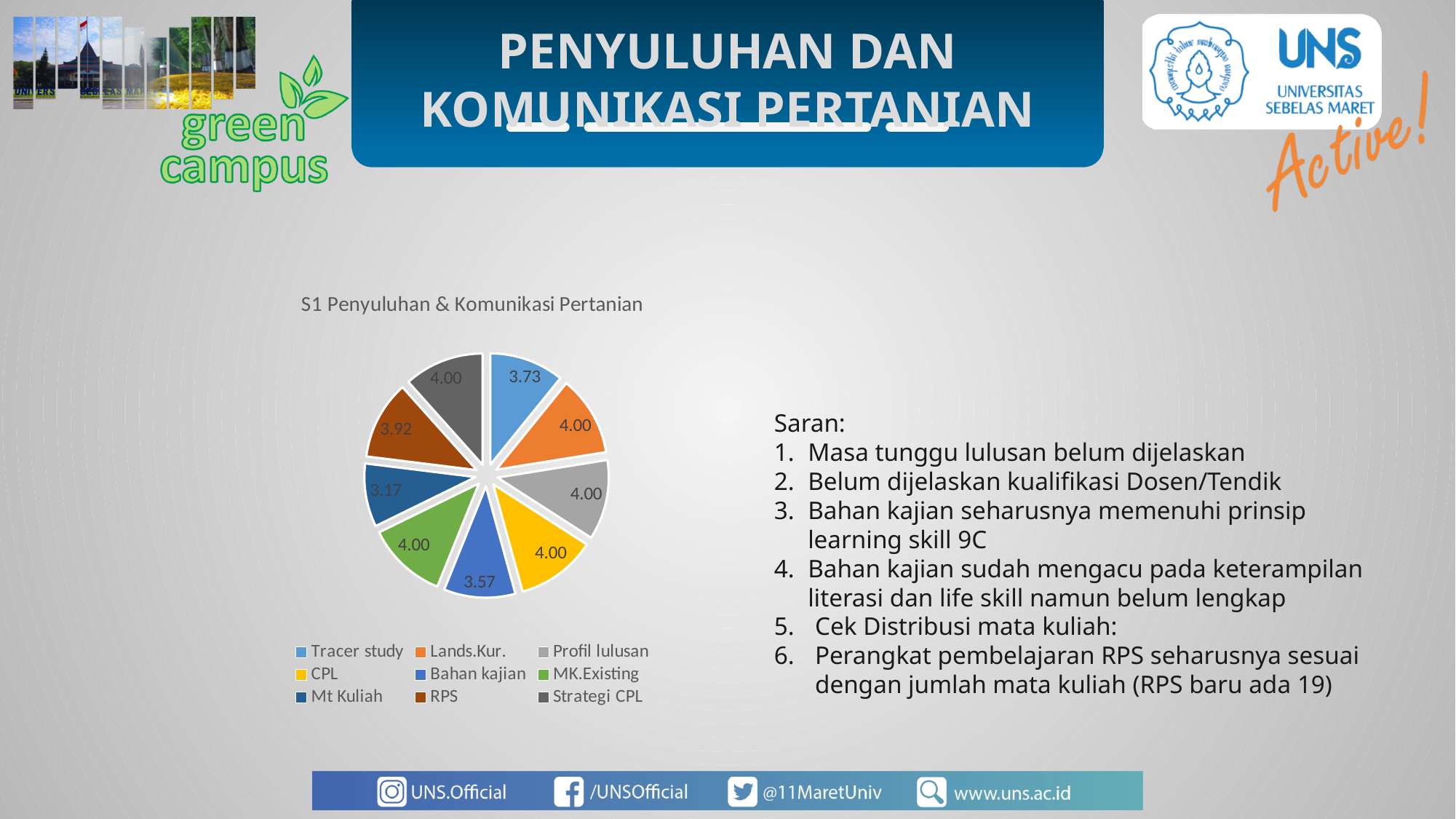
What is the difference between the values for Tracer study and Mt Kuliah? 0.56 What is the value for Tracer study? 3.73 Which is larger, the value for Tracer study or the value for Bahan kajian? Tracer study What kind of chart is shown on the slide? pie chart What is the value for Bahan kajian? 3.57 What is the value for Mt Kuliah? 3.17 What is the value for CPL? 4.00 What colour is the slice for MK.Existing? green What is the title of the chart? S1 Penyuluhan & Komunikasi Pertanian What is the value for RPS? 3.92 How many slices does the pie chart have? 9 Which category has the lowest value? Mt Kuliah